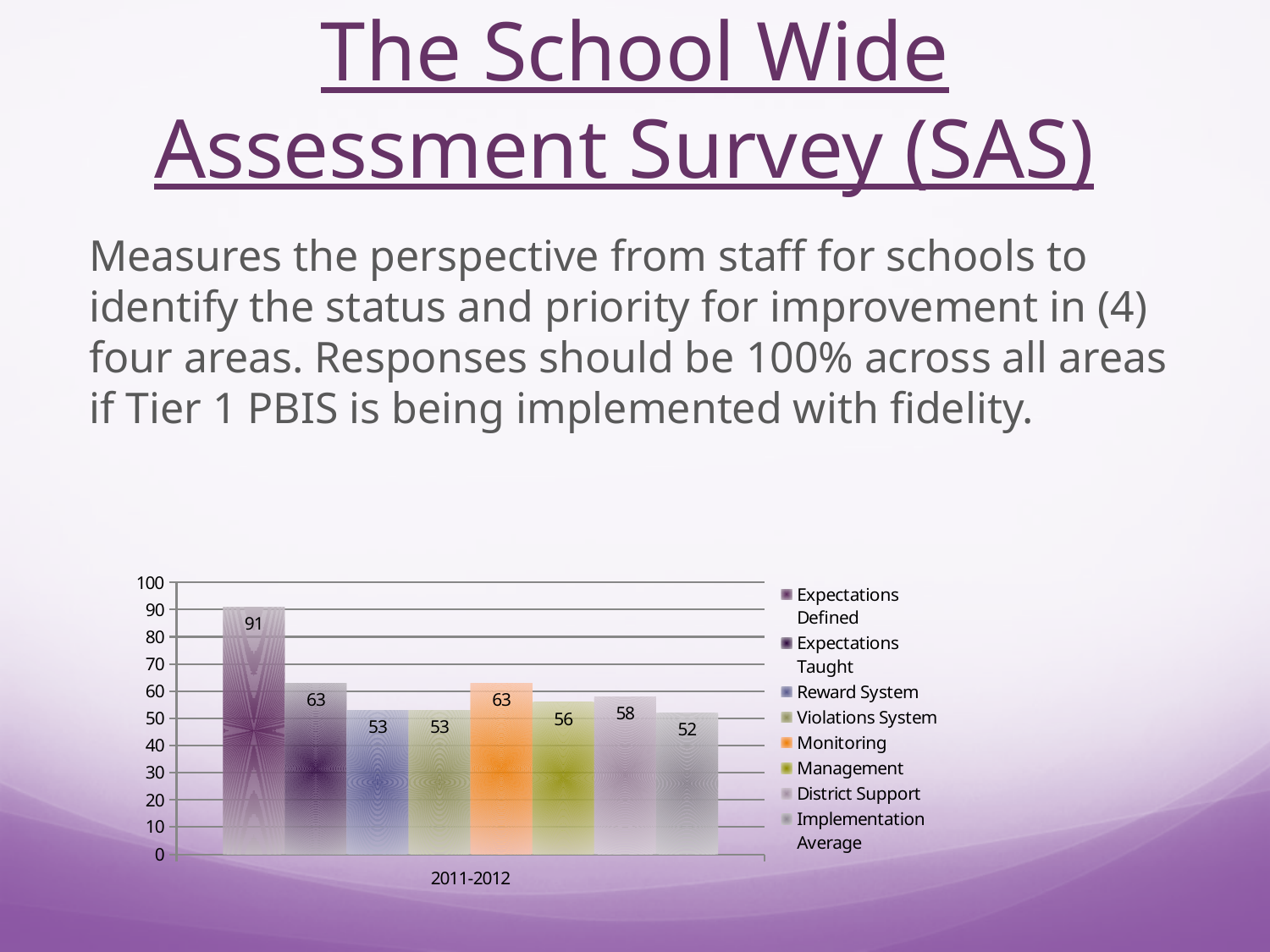
What is the value for Monitoring in 2011-2012? 63 What colour is the Monitoring bar? orange What is the difference between Expectations Defined and Expectations Taught in 2011-2012? 28 Which series has the highest value in 2011-2012? Expectations Defined What is the value for District Support in 2011-2012? 58 Which is larger in 2011-2012, Management or District Support? District Support What type of chart is shown on the slide? bar chart What is the value for Implementation Average in 2011-2012? 52 How many series does the legend list? 8 Which series has the lowest value in 2011-2012? Implementation Average What is the value for Expectations Defined in 2011-2012? 91 What is the only category label shown on the x axis? 2011-2012